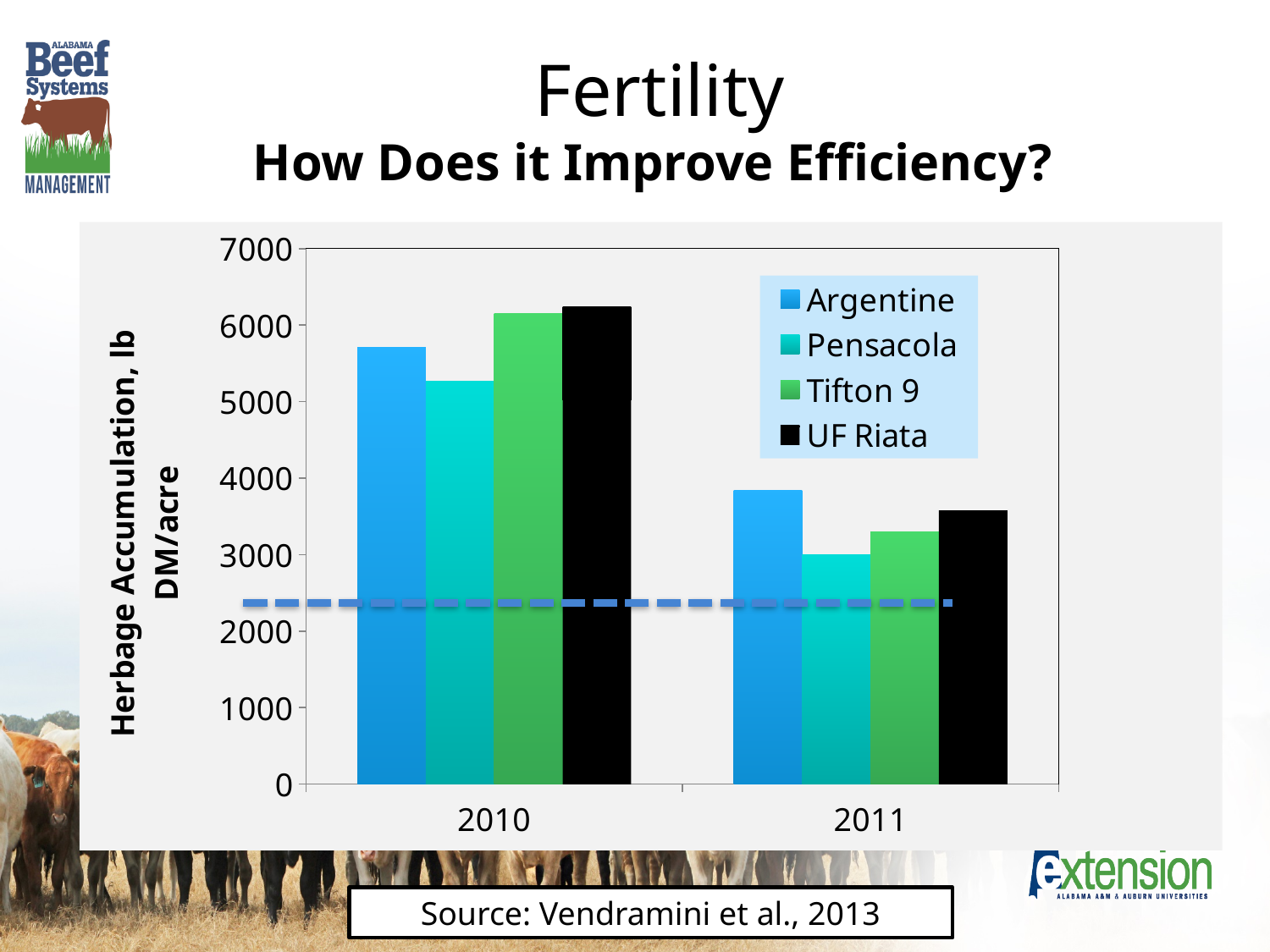
Which is larger: Tifton 9 in 2010 or Pensacola in 2010? Tifton 9 in 2010 How many series does the legend list? 4 Is the value for Argentine in 2010 greater or less than 5000? greater Which series has the lowest herbage accumulation in 2010? Pensacola What kind of chart is shown on the slide? bar chart What is the label on the y axis? Herbage Accumulation, lb DM/acre Which series has the highest herbage accumulation in 2011? Argentine How many year categories are shown on the x axis? 2 Is the value for Pensacola in 2010 greater or less than 6000? less Do the herbage accumulation values rise or fall from 2010 to 2011? fall What colour represents UF Riata in the legend? black Is the value for UF Riata in 2011 greater or less than 4000? less